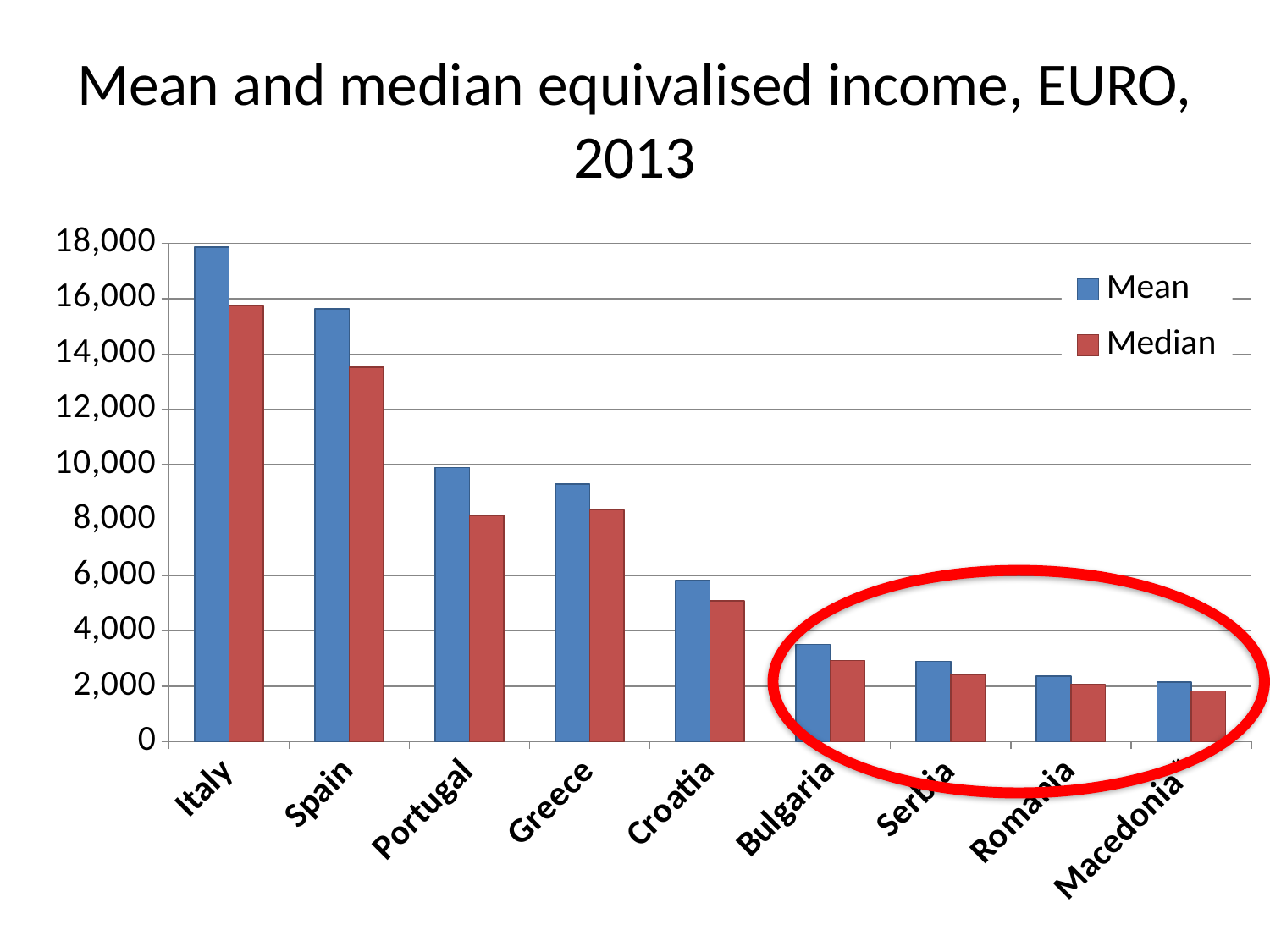
What kind of chart is shown on the slide? Bar chart How many countries are shown on the x axis? 9 Which country has the lowest median equivalised income? Macedonia Is the mean value for Italy greater or less than 16,000? greater Which series is shown in blue? Mean Do the mean values rise or fall moving from Italy to Macedonia along the x axis? Fall Is the median value for Croatia greater or less than 4,000? greater Is the mean value for Bulgaria greater or less than 4,000? less Which country has the highest mean equivalised income? Italy Which is larger, the mean value for Spain or the mean value for Portugal? Spain How many series does the legend list? 2